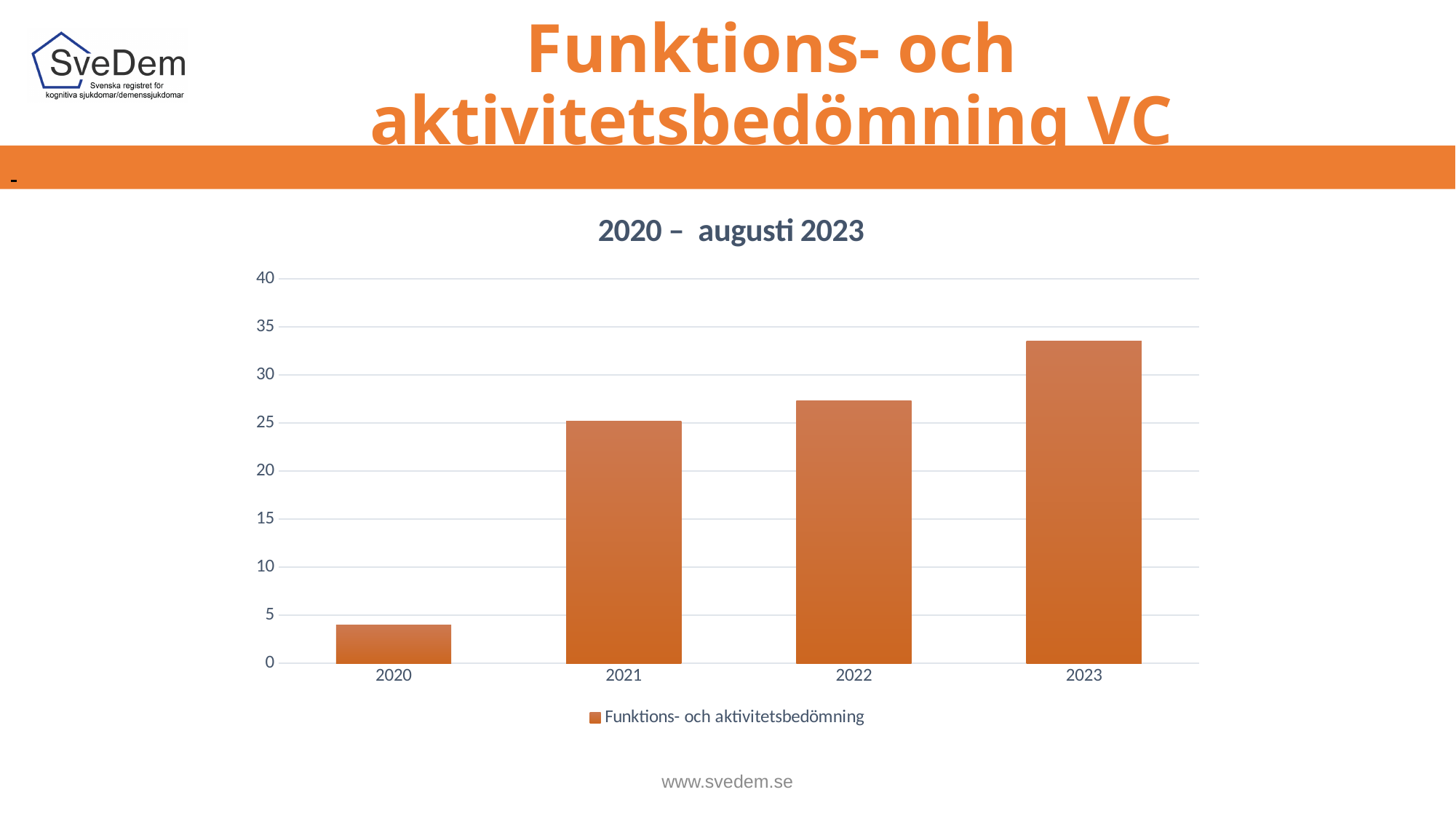
How many years are shown on the x axis of the chart? 4 Is the value for 2023 greater or less than 30? greater What is the title shown above the chart? 2020 – augusti 2023 What kind of chart is shown on the slide? bar chart How many series does the chart legend list? 1 Which year has the highest bar in the chart? 2023 Is the value for 2020 greater or less than 5? less Which is larger, the value for 2021 or the value for 2023? 2023 Is the value for 2022 greater or less than 30? less Do the values rise or fall from 2020 to 2023? rise Which year has the lowest bar in the chart? 2020